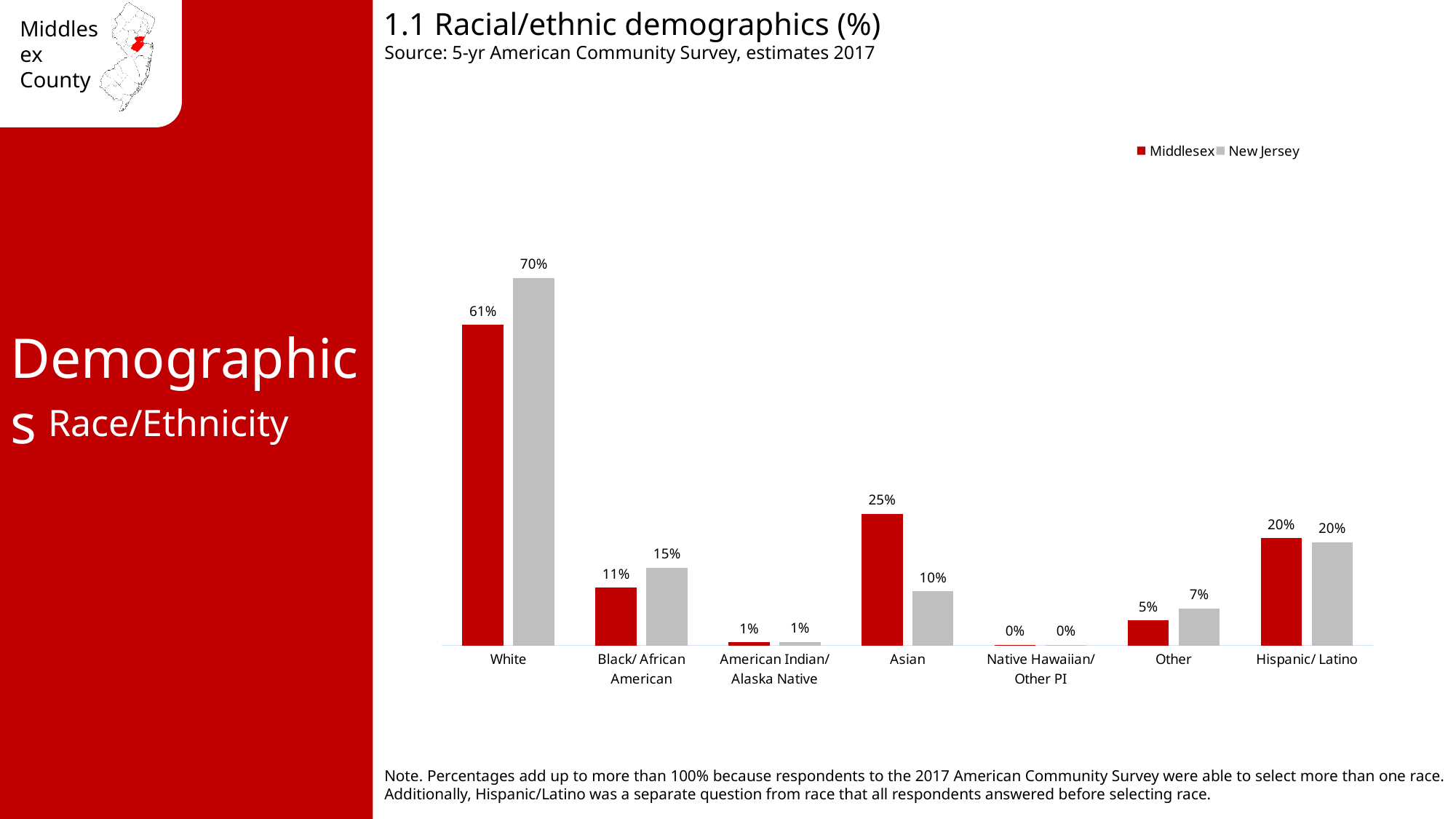
What is the difference between the Middlesex and New Jersey values for Asian? 15% Which category has the highest Middlesex value? White What is the New Jersey value for Black/ African American? 15% What is the New Jersey value for Asian? 10% How many series does the legend list? 2 How many categories are shown on the x axis? 7 Which category has the lowest New Jersey value? Native Hawaiian/ Other PI What is the Middlesex value for Other? 5% What is the Middlesex value for White? 61% What is the difference between the New Jersey and Middlesex values for White? 9% What kind of chart is shown on the slide? bar chart Which is larger for Black/ African American, the Middlesex value or the New Jersey value? New Jersey